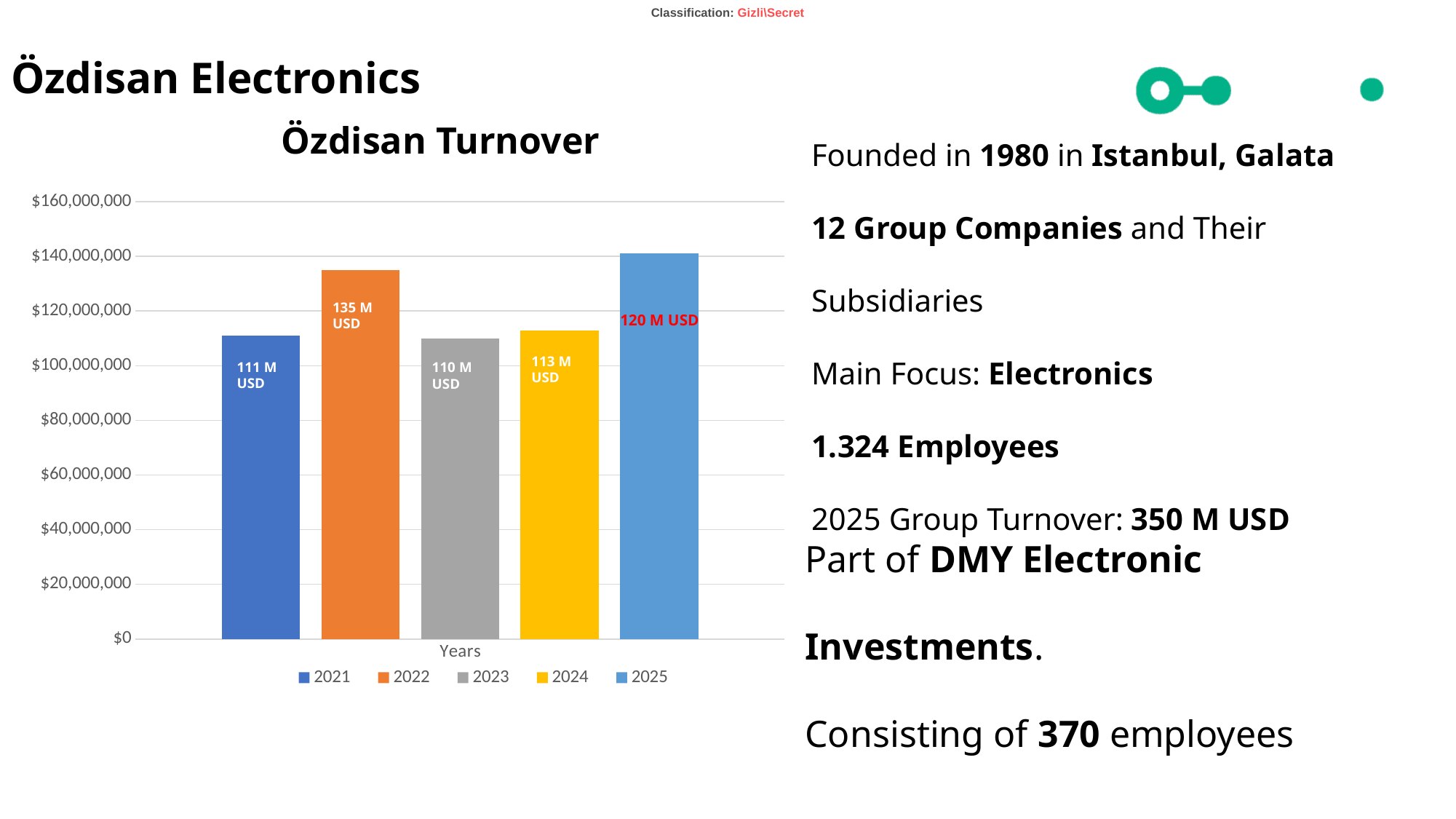
What is the data label shown for 2022 in the Özdisan Turnover chart? 135 M USD By how much does the labelled turnover for 2022 exceed that for 2021? 24 M USD What is the data label shown for 2024 in the Özdisan Turnover chart? 113 M USD Which year has the larger labelled turnover, 2021 or 2022? 2022 What is the data label shown for 2023 in the Özdisan Turnover chart? 110 M USD Is the value for 2023 greater or less than $120,000,000? less What is the data label shown for 2021 in the Özdisan Turnover chart? 111 M USD How many bars are plotted in the Özdisan Turnover chart? 5 Which year has the lowest turnover in the Özdisan Turnover chart? 2023 What kind of chart is the Özdisan Turnover chart? bar chart What is the title of the horizontal axis in the Özdisan Turnover chart? Years What is the data label shown for 2025 in the Özdisan Turnover chart? 120 M USD